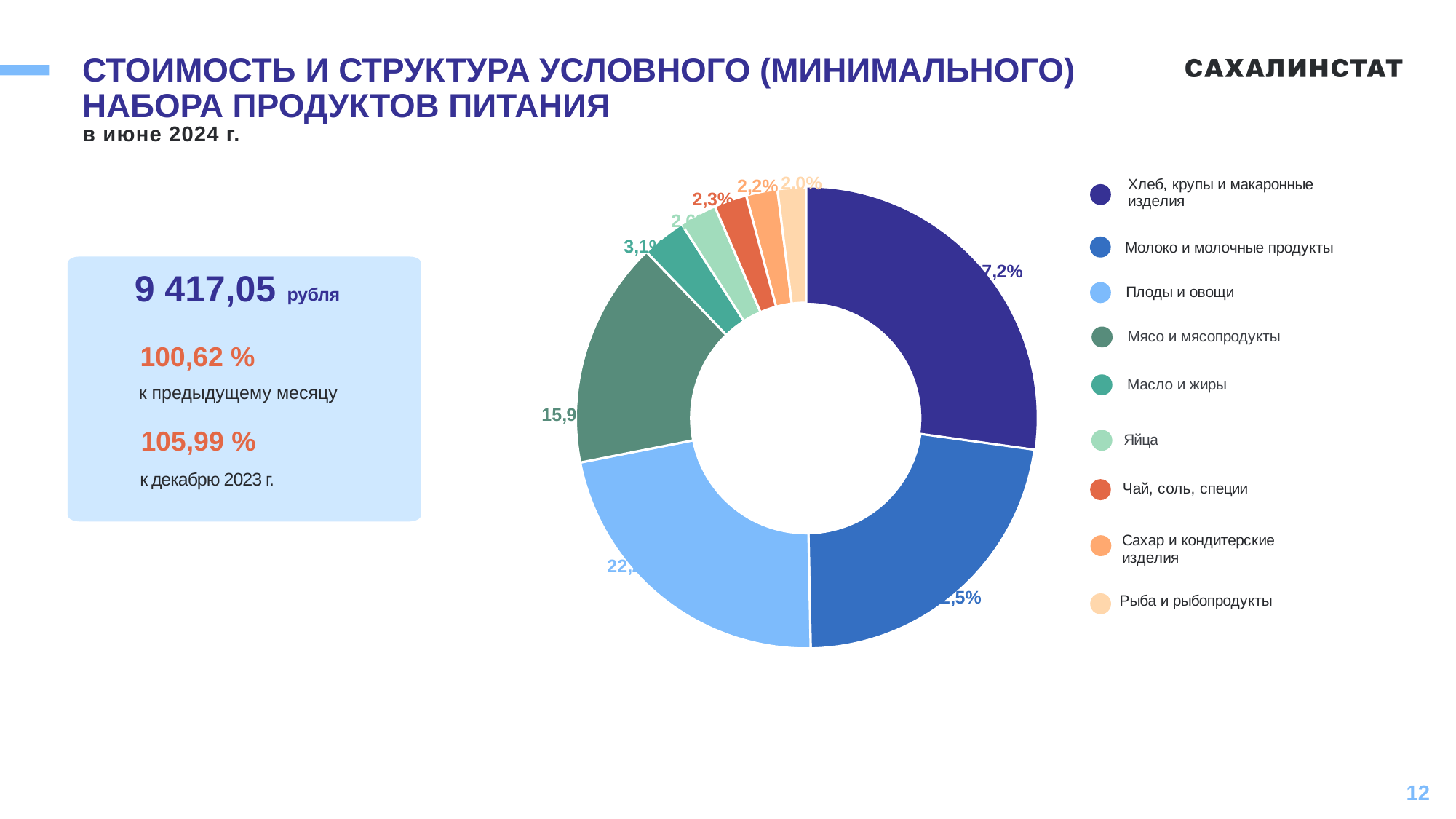
What share of the chart does "Масло и жиры" have? 3,1% What is the difference between the shares of "Масло и жиры" and "Сахар и кондитерские изделия"? 0,9% What is the difference between the shares of "Чай, соль, специи" and "Рыба и рыбопродукты"? 0,3% What share of the chart does "Рыба и рыбопродукты" have? 2,0% What share of the chart does "Чай, соль, специи" have? 2,3% Which category has the largest slice in the chart? Хлеб, крупы и макаронные изделия What kind of chart is shown on the slide? Donut (pie) chart What colour represents "Мясо и мясопродукты" in the chart legend? Green Which category has the smallest slice in the chart? Рыба и рыбопродукты How many categories does the legend of the chart list? 9 What share of the chart does "Сахар и кондитерские изделия" have? 2,2% Which slice is larger: "Плоды и овощи" or "Мясо и мясопродукты"? Плоды и овощи